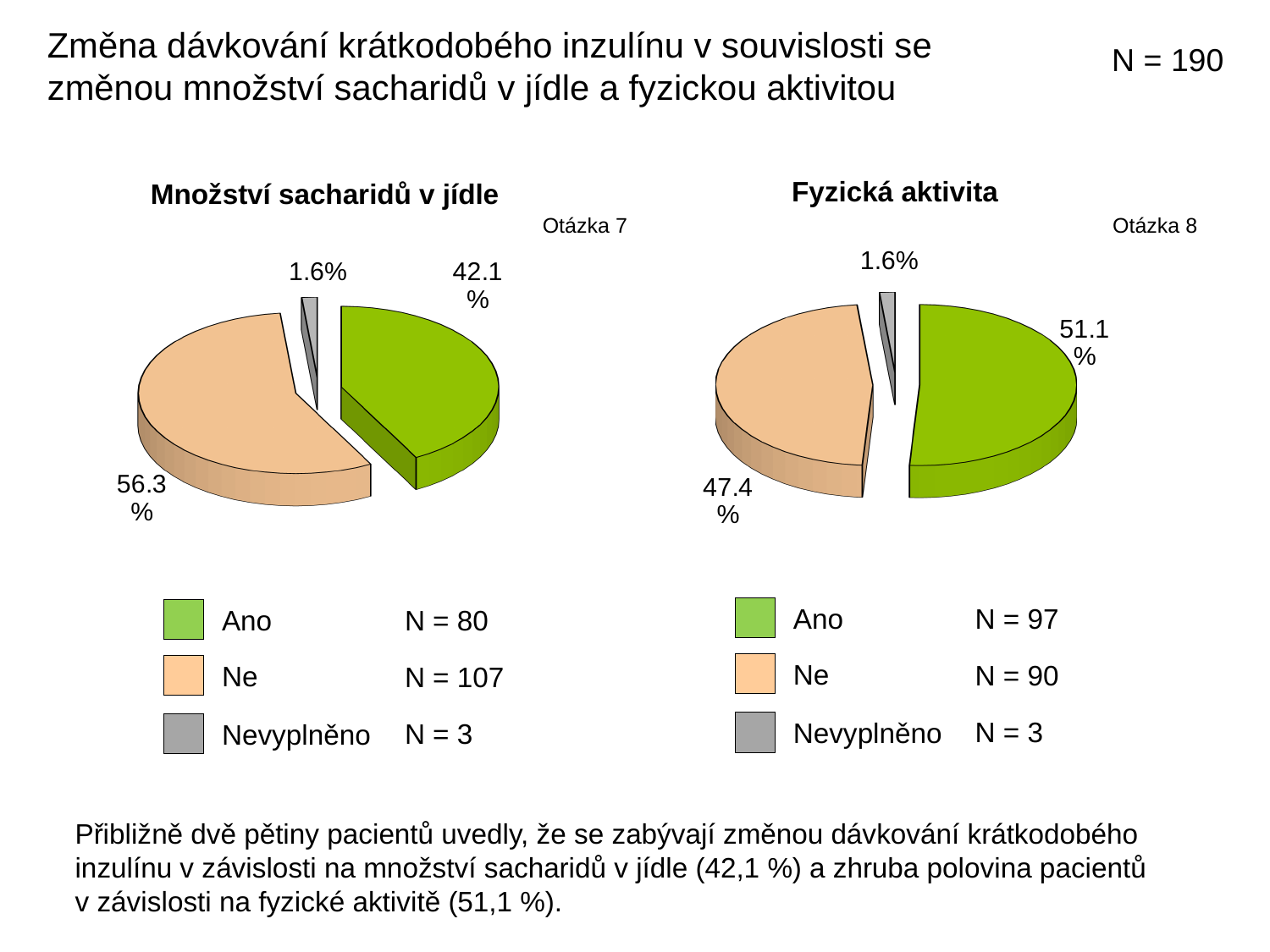
What kind of chart is used in the 'Množství sacharidů v jídle' chart? Pie chart In the 'Množství sacharidů v jídle' chart, what percentage is shown for the 'Ano' slice? 42.1% In the 'Množství sacharidů v jídle' chart, what is the difference in percentage points between the 'Ne' and 'Ano' slices? 14.2 In the 'Fyzická aktivita' chart, what percentage is shown for the 'Nevyplněno' slice? 1.6% In the 'Fyzická aktivita' chart, what colour is the 'Ne' slice? Light orange (peach) How many slices does the 'Fyzická aktivita' pie chart have? 3 In the 'Množství sacharidů v jídle' chart, which category has the largest slice? Ne In the 'Množství sacharidů v jídle' chart, what percentage is shown for the 'Ne' slice? 56.3% In the 'Fyzická aktivita' chart, which slice is larger, 'Ano' or 'Ne'? Ano In the 'Fyzická aktivita' chart, what percentage is shown for the 'Ano' slice? 51.1% In the 'Fyzická aktivita' chart, which category has the smallest slice? Nevyplněno How many entries does the legend of the 'Množství sacharidů v jídle' chart list? 3